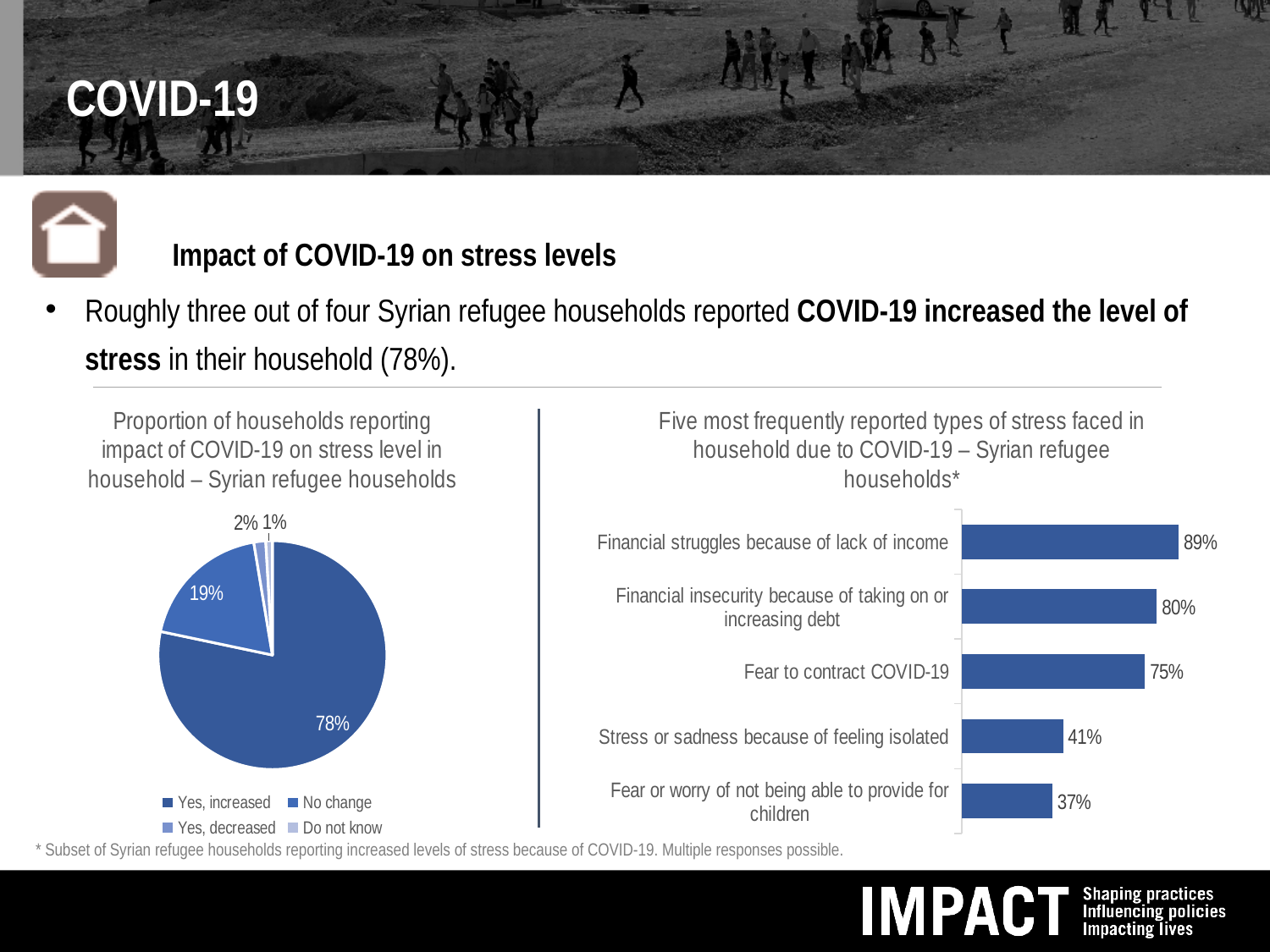
In the pie chart on the left, what share of households reported no change in stress level? 19% In the bar chart on the right, what is the difference between 'Financial struggles because of lack of income' and 'Stress or sadness because of feeling isolated'? 48 percentage points In the bar chart on the right, which is larger: 'Financial insecurity because of taking on or increasing debt' or 'Fear to contract COVID-19'? Financial insecurity because of taking on or increasing debt In the bar chart on the right, which type of stress was reported least frequently? Fear or worry of not being able to provide for children How many categories does the legend of the pie chart on the left list? 4 In the pie chart on the left, which category has the smallest slice? Do not know In the pie chart on the left, what proportion of households reported that COVID-19 increased their stress level? 78% How many types of stress are shown in the bar chart on the right? 5 What kind of chart is the chart on the right of the slide? Bar chart In the bar chart on the right, what percentage of households reported financial struggles because of lack of income? 89% In the bar chart on the right, what is the value for 'Fear to contract COVID-19'? 75% In the pie chart on the left, which category has the largest slice? Yes, increased